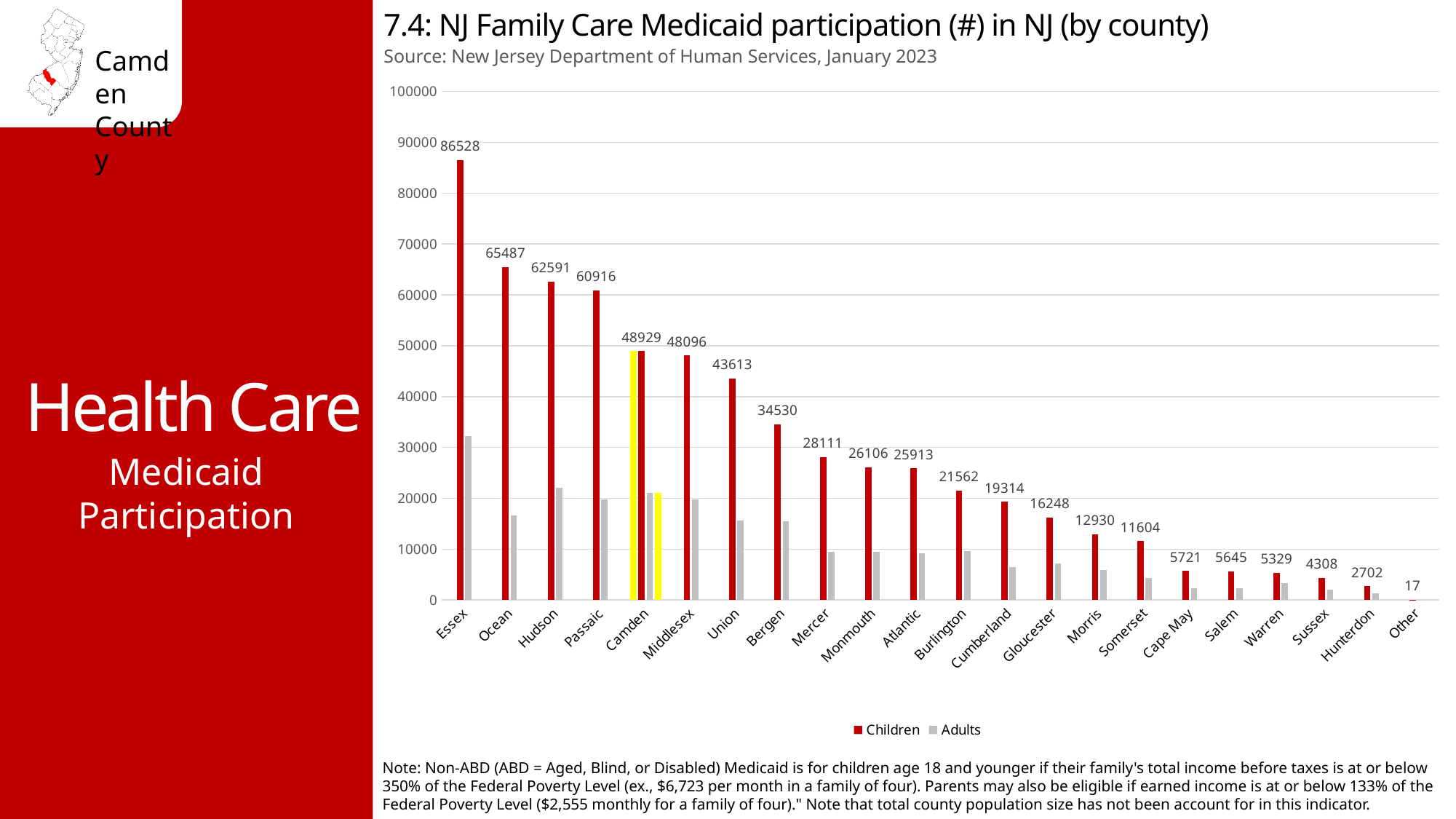
What is the Children value for Camden? 48929 What kind of chart is shown on the slide? Bar chart Is the Adults value for Ocean greater or less than 20000? less Which county has the highest Children value? Essex Is the Adults value for Essex greater or less than 30000? greater Which has a larger Children value, Camden or Middlesex? Camden Which category has the lowest Children value? Other What is the Children value for Cape May? 5721 What is the difference between the Children values for Essex and Ocean? 21041 What is the Children value for Essex? 86528 How many series does the legend list? 2 How many categories are shown on the x axis? 22